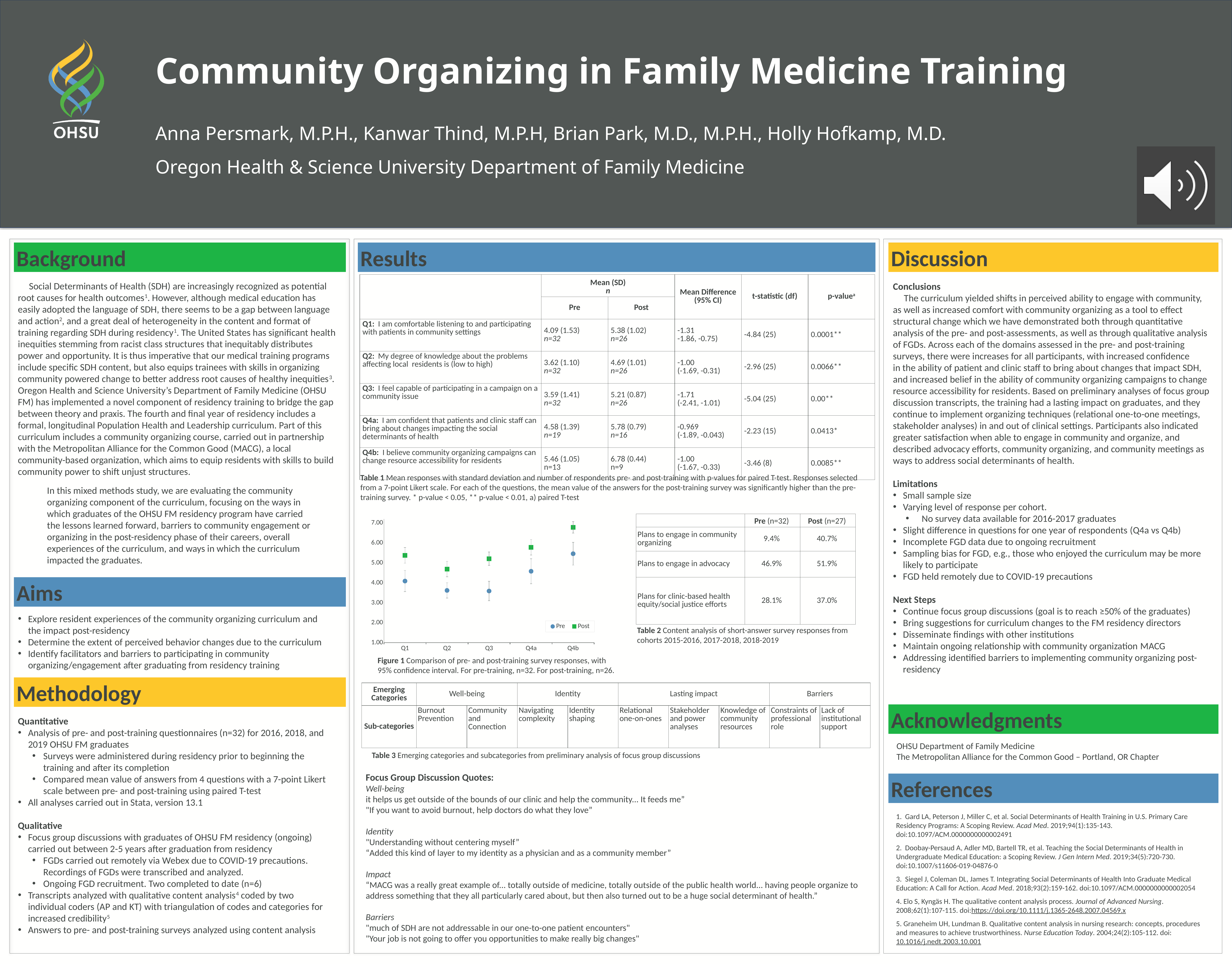
In Figure 1, do the Post values rise or fall from Q3 to Q4b? rise In Figure 1, is the Post value for Q1 greater or less than 5.00? greater In Figure 1, is the Post value for Q4b greater or less than 6.00? greater In Figure 1, which is larger for Q3: the Pre value or the Post value? Post In Figure 1, which category has the highest Pre value? Q4b How many question categories are shown on the x axis of Figure 1? 5 In Figure 1, which category has the lowest Post value? Q2 How many series does the legend of Figure 1 list? 2 What kind of chart is Figure 1? Scatter (dot) plot with error bars In Figure 1, which colour marks the Post series? Green In Figure 1, is the Pre value for Q2 greater or less than 4.00? less In Figure 1, which category has the highest Post value? Q4b